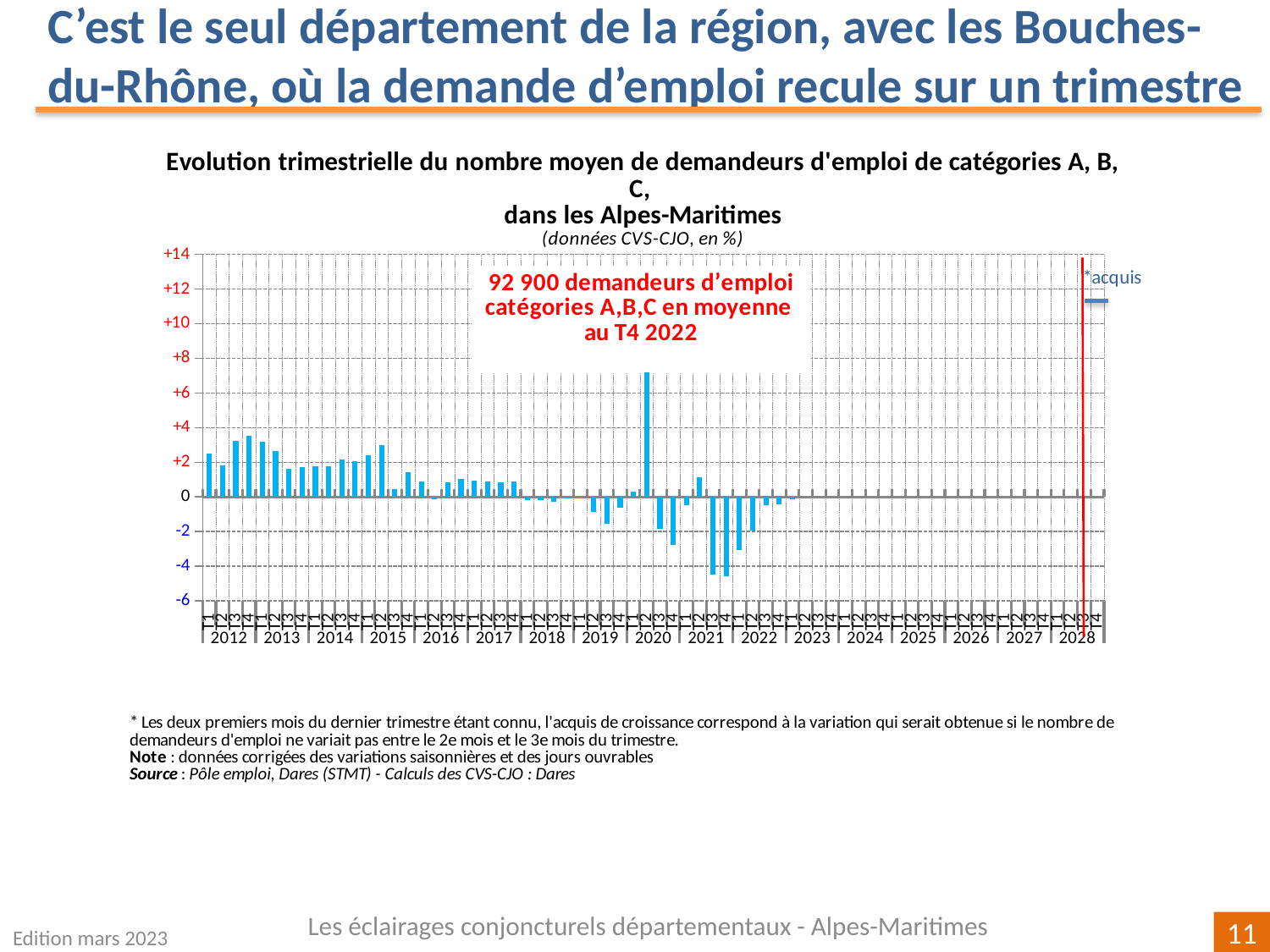
In which year do the lowest bars of the chart occur? 2021 What kind of chart is shown on the slide? bar chart Are the bars in 2021 mostly positive or negative? negative Is the value of the highest bar (in 2020) greater or less than +6? greater What is the lowest value shown on the vertical axis? -6 Are the bars in 2012 and 2013 mostly positive or negative? positive Is the value for T1 2013 greater or less than +2? greater How many years are labelled on the horizontal axis? 17 Is the highest bar in 2020 larger than the highest bar in 2013? yes What is the highest value shown on the vertical axis? +14 In which year does the highest bar of the chart occur? 2020 Is the value of the lowest bar (in 2021) greater or less than -2? less